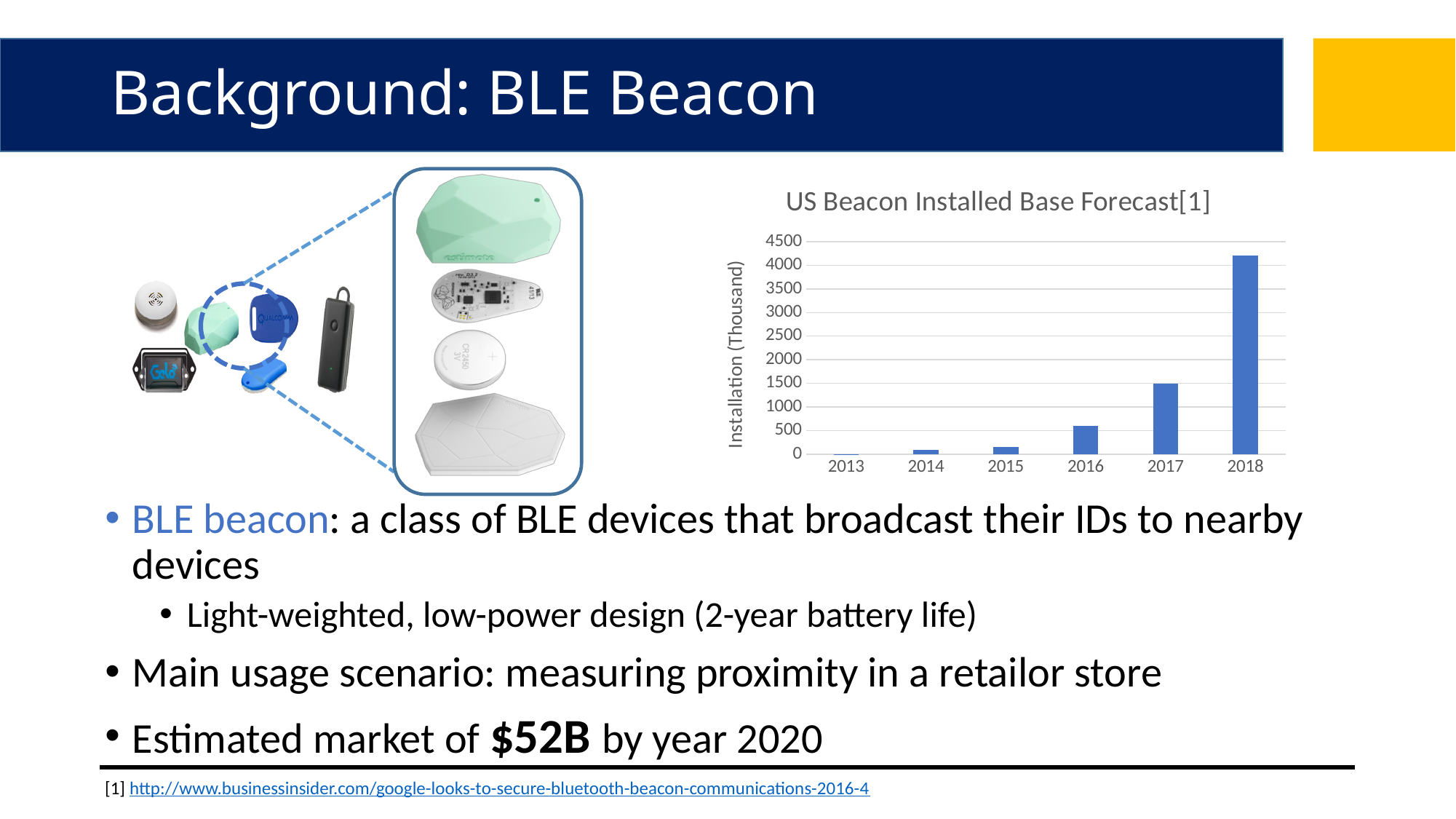
Do the values in the chart rise or fall from 2013 to 2018? rise Which year has the lowest installed base in the chart? 2013 How many years are shown on the x axis of the chart? 6 Which year has the highest installed base in the chart? 2018 Which year has a larger installed base, 2016 or 2017? 2017 Is the value for 2015 greater or less than 500? less What kind of chart is shown on the slide? bar chart Is the value for 2018 greater or less than 4000? greater Is the value for 2017 greater or less than 2000? less What is the label of the vertical axis of the chart? Installation (Thousand) What is the title of the chart? US Beacon Installed Base Forecast[1]